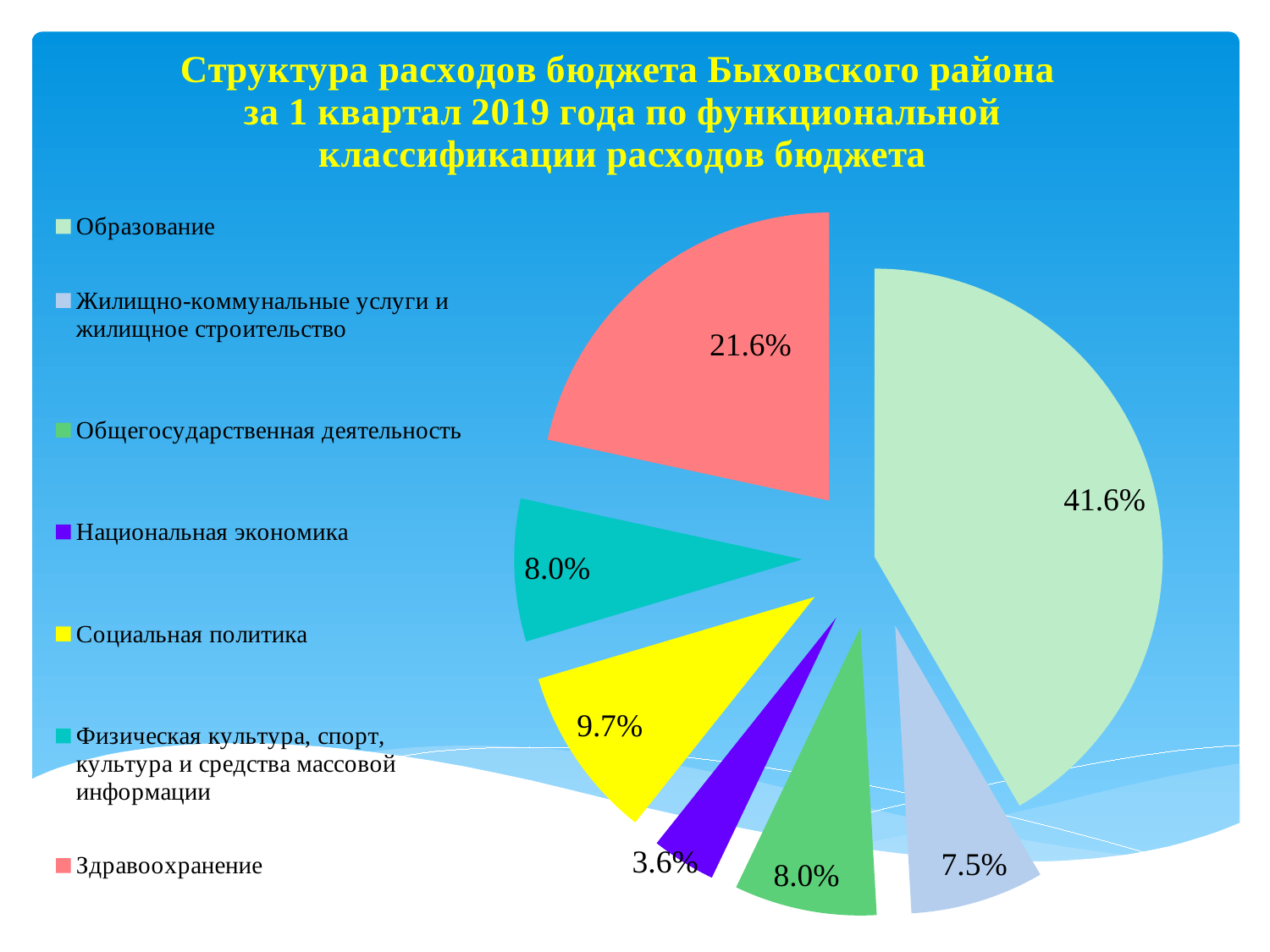
How many categories does the pie chart have? 7 Which category has the smallest share of the pie? Национальная экономика Which is larger: the share for Социальная политика or the share for Жилищно-коммунальные услуги и жилищное строительство? Социальная политика What is the difference in percentage points between Образование and Здравоохранение? 20.0 What share of budget expenditure goes to Жилищно-коммунальные услуги и жилищное строительство? 7.5% What share of budget expenditure goes to Национальная экономика? 3.6% What share of budget expenditure goes to Здравоохранение? 21.6% What share of budget expenditure goes to Социальная политика? 9.7% What share of budget expenditure goes to Образование? 41.6% What type of chart is shown on the slide? pie chart Which category has the largest share of the pie? Образование What colour is the slice for Здравоохранение? pink (light red)